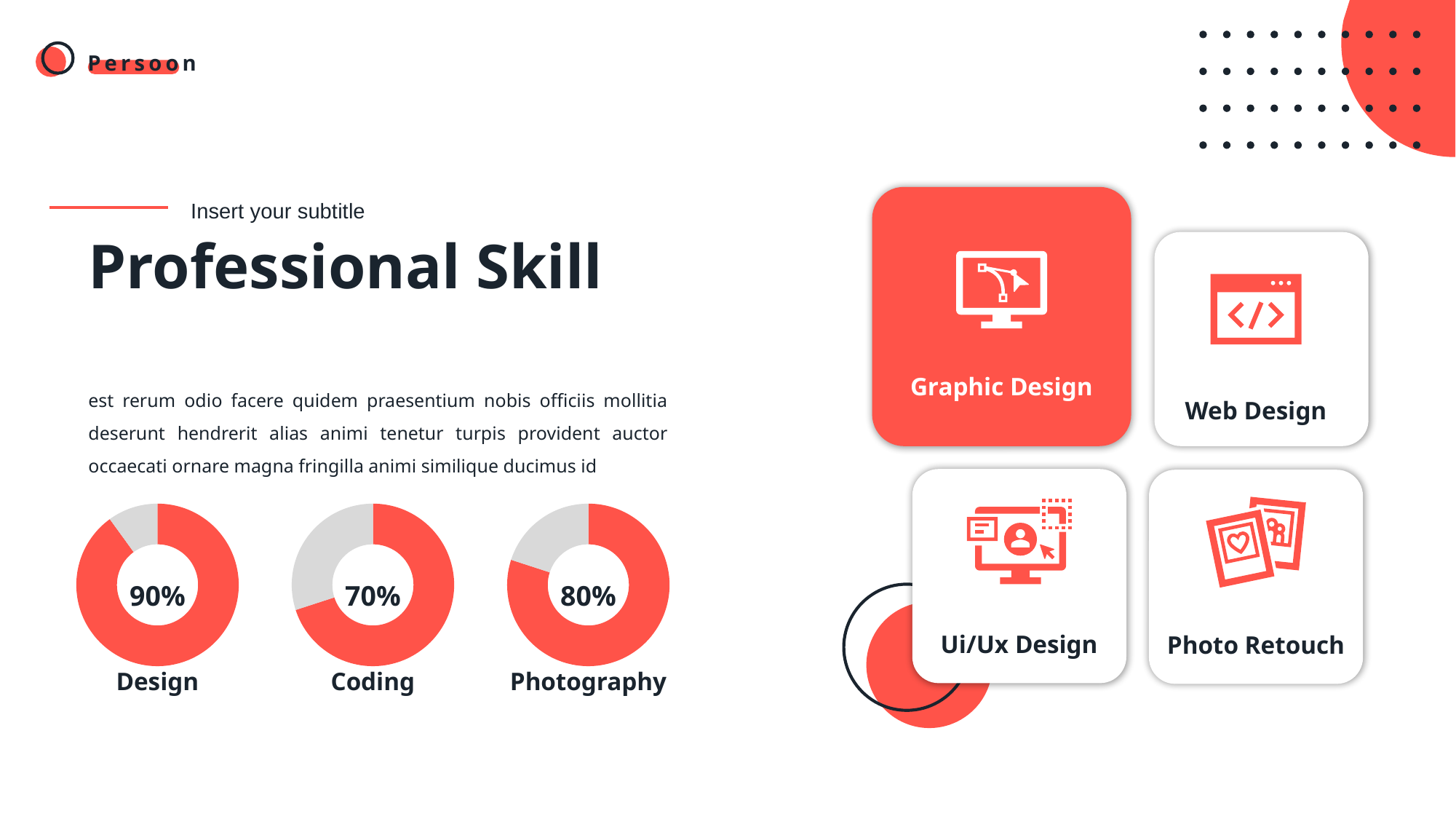
What value is shown in the Design donut chart? 90% What kind of chart is used to show the skill percentages? Donut chart Which of the three skill charts shows the lowest percentage? Coding What colour is the filled portion of the donut charts? Red What is the label under the middle donut chart? Coding What is the difference between the Photography and Coding percentages? 10% What value is shown in the Photography donut chart? 80% How many donut charts are shown on the slide? 3 Which is larger, the Design percentage or the Photography percentage? Design Which of the three skill charts shows the highest percentage? Design What is the difference between the Design and Coding percentages? 20% What value is shown in the Coding donut chart? 70%